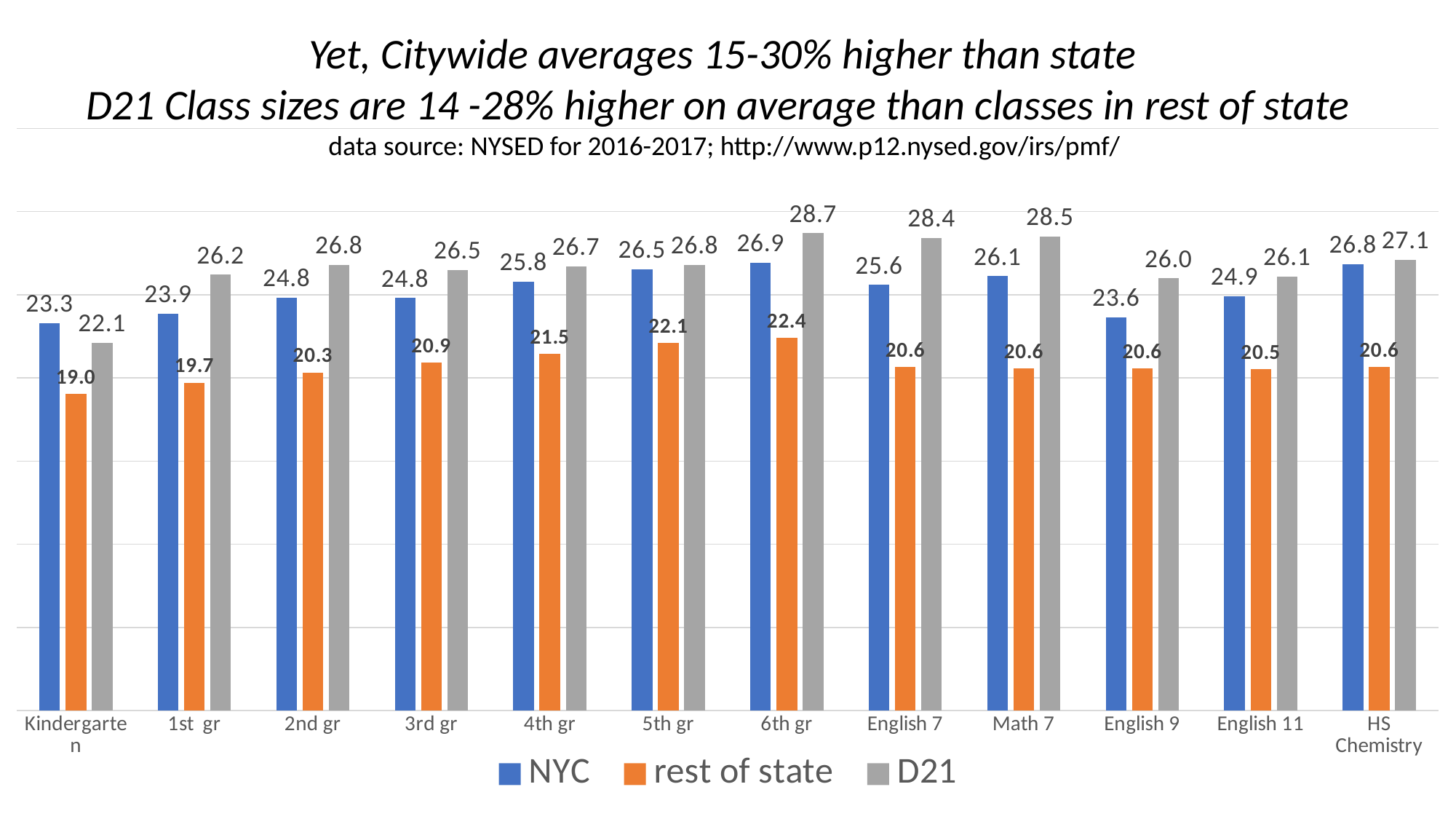
What is the rest of state value for Kindergarten? 19.0 For Kindergarten, which is larger: the NYC value or the D21 value? NYC What is the rest of state value for 4th gr? 21.5 Which series is shown in orange? rest of state Which category has the highest D21 value? 6th gr What kind of chart is shown on the slide? bar chart What is the difference between the D21 and rest of state values for 6th gr? 6.3 What is the D21 value for Math 7? 28.5 How many categories are shown on the x axis? 12 What is the NYC value for 6th gr? 26.9 Which category has the lowest rest of state value? Kindergarten How many series does the legend list? 3